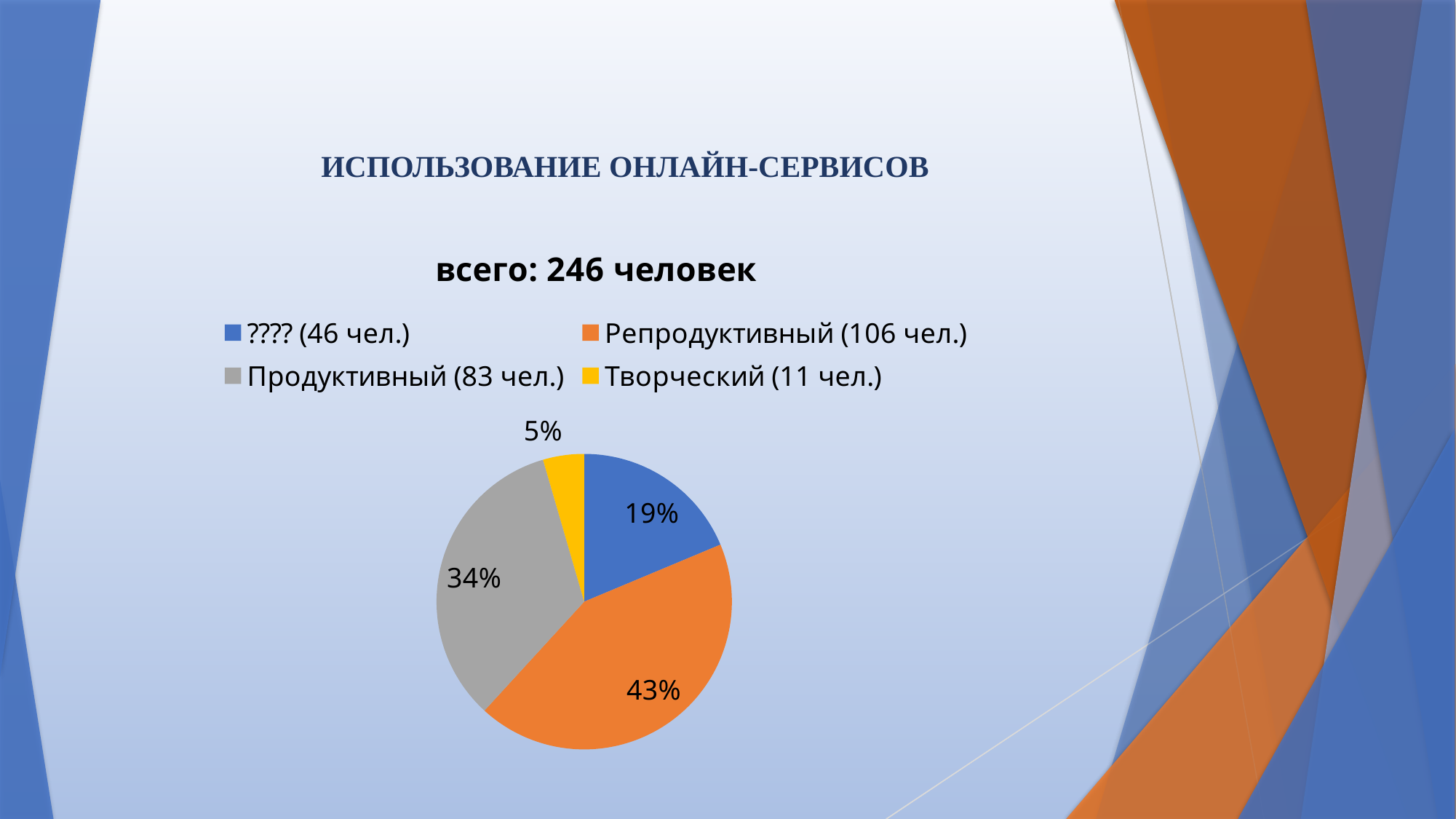
How many people are in the Творческий category according to the legend? 11 чел. What share of the pie does the Продуктивный slice represent? 34% What kind of chart is shown on the slide? pie chart What is the difference in percentage points between the Репродуктивный slice and the Продуктивный slice? 9% Which slice is larger, Продуктивный or Репродуктивный? Репродуктивный What is the title of the pie chart? всего: 246 человек Which category has the smallest slice of the pie? Творческий What share of the pie does the Репродуктивный slice represent? 43% What colour is the Продуктивный slice in the pie chart? gray Which category has the largest slice of the pie? Репродуктивный How many slices does the pie chart have? 4 What share of the pie does the Творческий slice represent? 5%